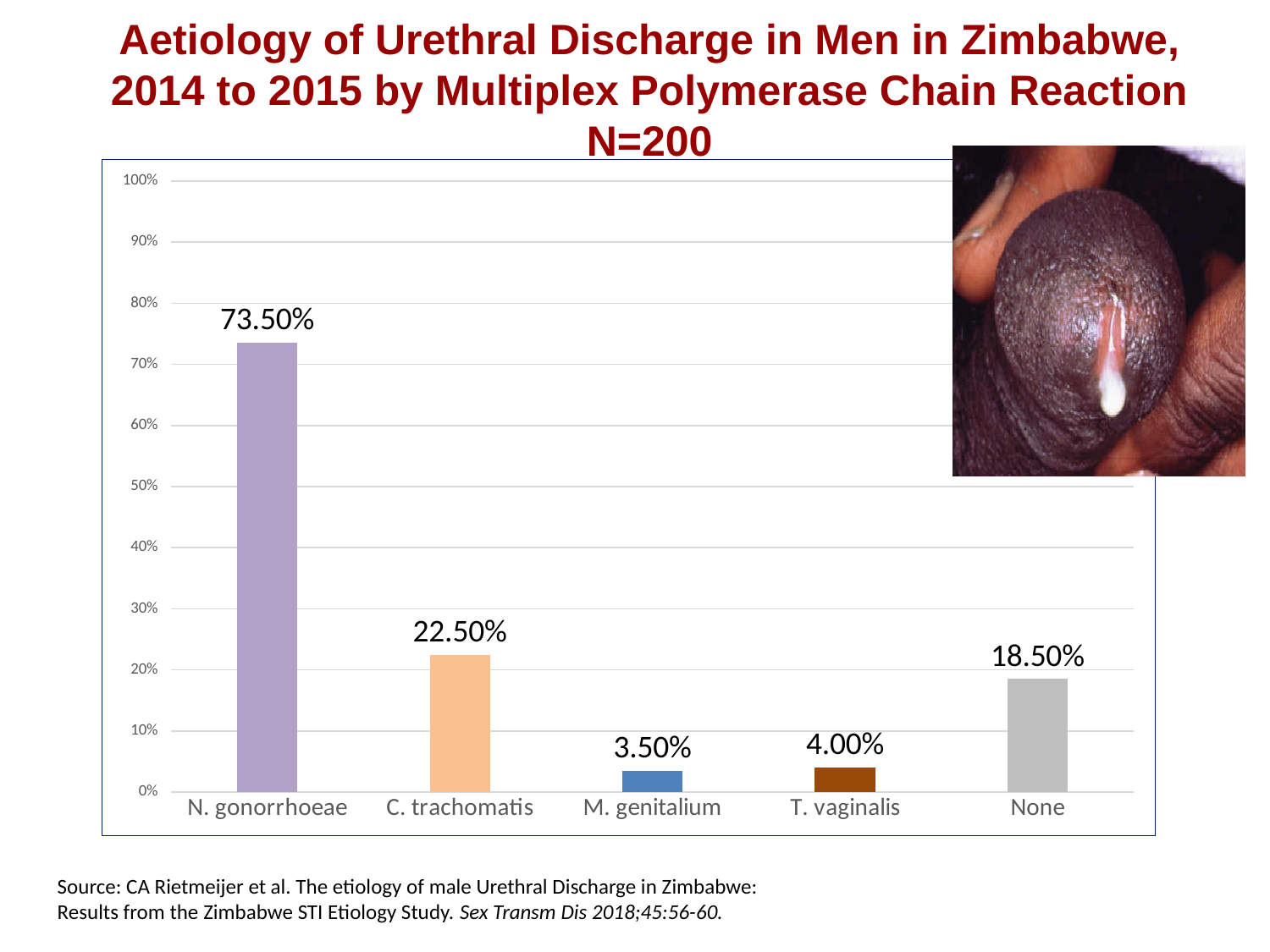
What is the difference between the values for N. gonorrhoeae and C. trachomatis? 51.00% How many categories are shown on the x axis? 5 What is the value for None? 18.50% What is the value for N. gonorrhoeae? 73.50% What is the value for T. vaginalis? 4.00% What kind of chart is shown on the slide? Bar chart What is the sample size (N) stated in the chart title? N=200 Which category has the lowest value? M. genitalium Which category has the highest value? N. gonorrhoeae Which is larger, the value for C. trachomatis or the value for None? C. trachomatis What is the value for C. trachomatis? 22.50% What is the value for M. genitalium? 3.50%